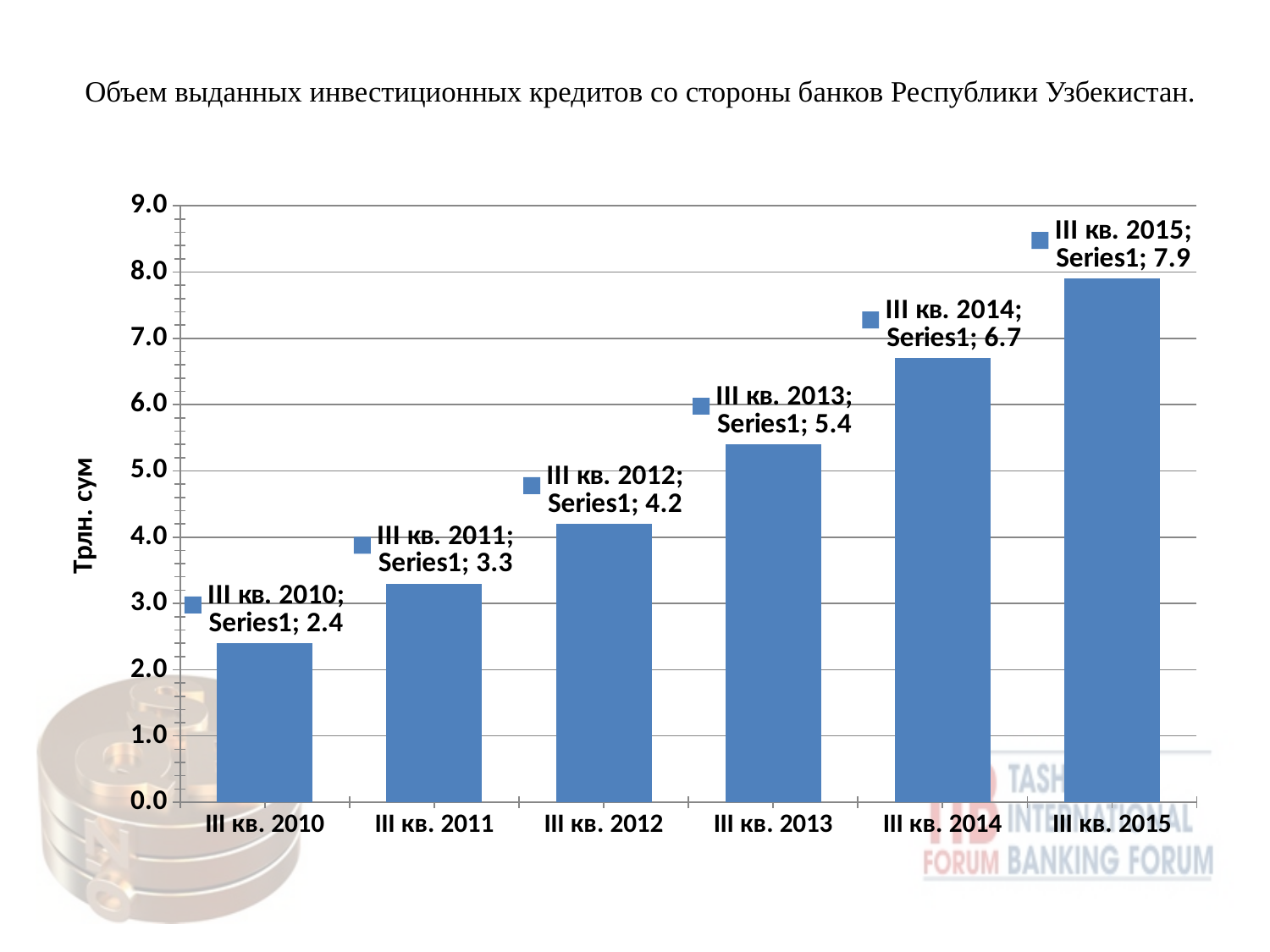
What is the value for III кв. 2012? 4.2 Which category has the lowest value? III кв. 2010 How many categories are shown on the x axis? 6 Which category has the highest value? III кв. 2015 Do the values rise or fall from III кв. 2010 to III кв. 2015? rise What kind of chart is shown on the slide? bar chart What is the difference between the values for III кв. 2013 and III кв. 2012? 1.2 What is the difference between the values for III кв. 2015 and III кв. 2010? 5.5 What is the value for III кв. 2014? 6.7 Which is larger, the value for III кв. 2011 or the value for III кв. 2013? III кв. 2013 What is the label of the vertical axis? Трлн. сум Is the value for III кв. 2014 greater or less than 6.0? greater